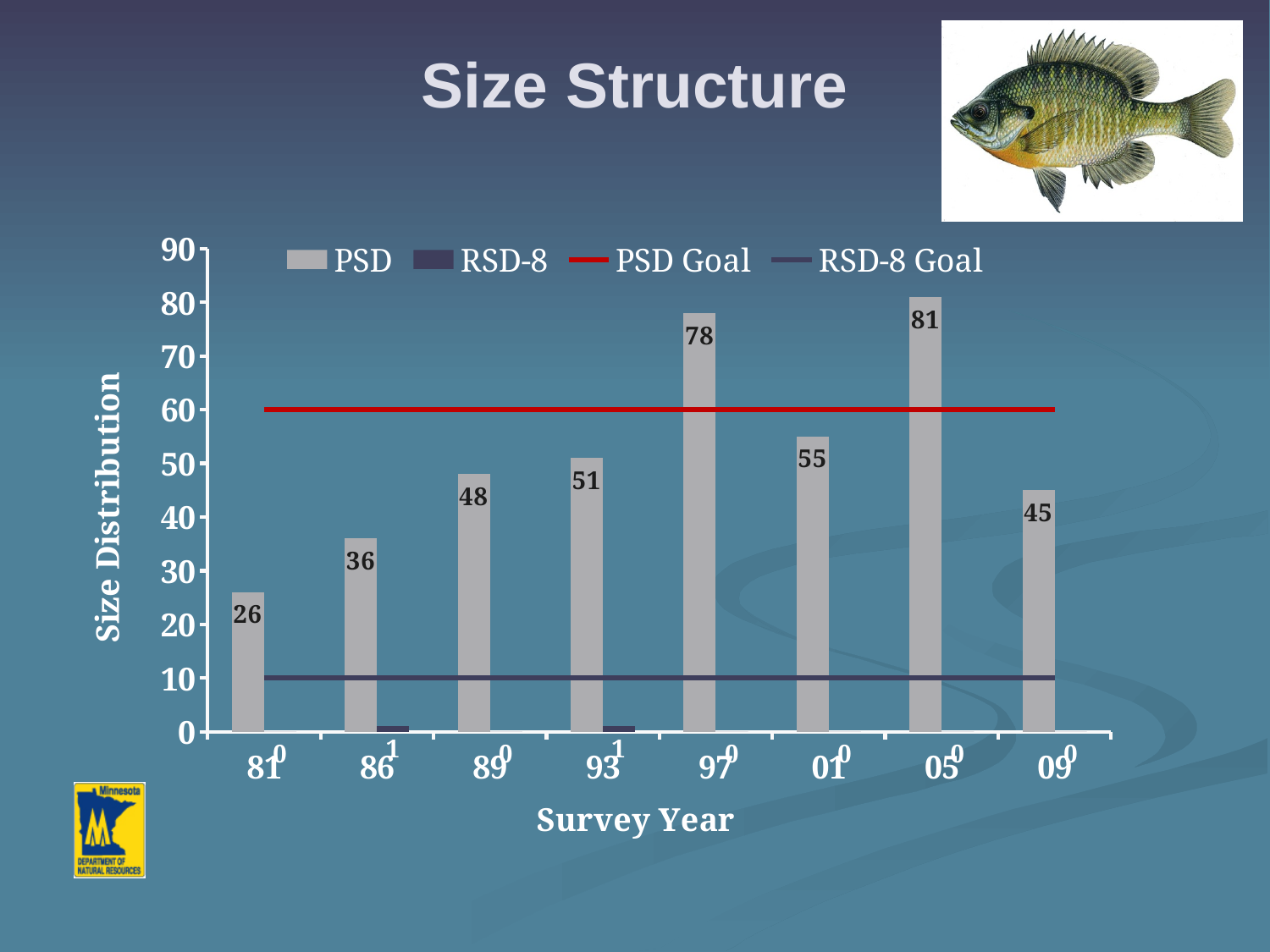
How many entries does the legend list? 4 Which survey year has the lowest PSD value? 81 What is the RSD-8 value for survey year 86? 1 Which is larger, the PSD value for 89 or for 93? 93 What is the label of the y axis? Size Distribution What is the PSD value for survey year 81? 26 What is the PSD value for survey year 97? 78 Which survey year has the highest PSD value? 05 How many survey years are shown on the x axis? 8 Is the PSD value for survey year 01 greater or less than 60? less What is the difference between the PSD values for survey years 05 and 09? 36 What kind of chart is shown on the slide? combination bar and line chart